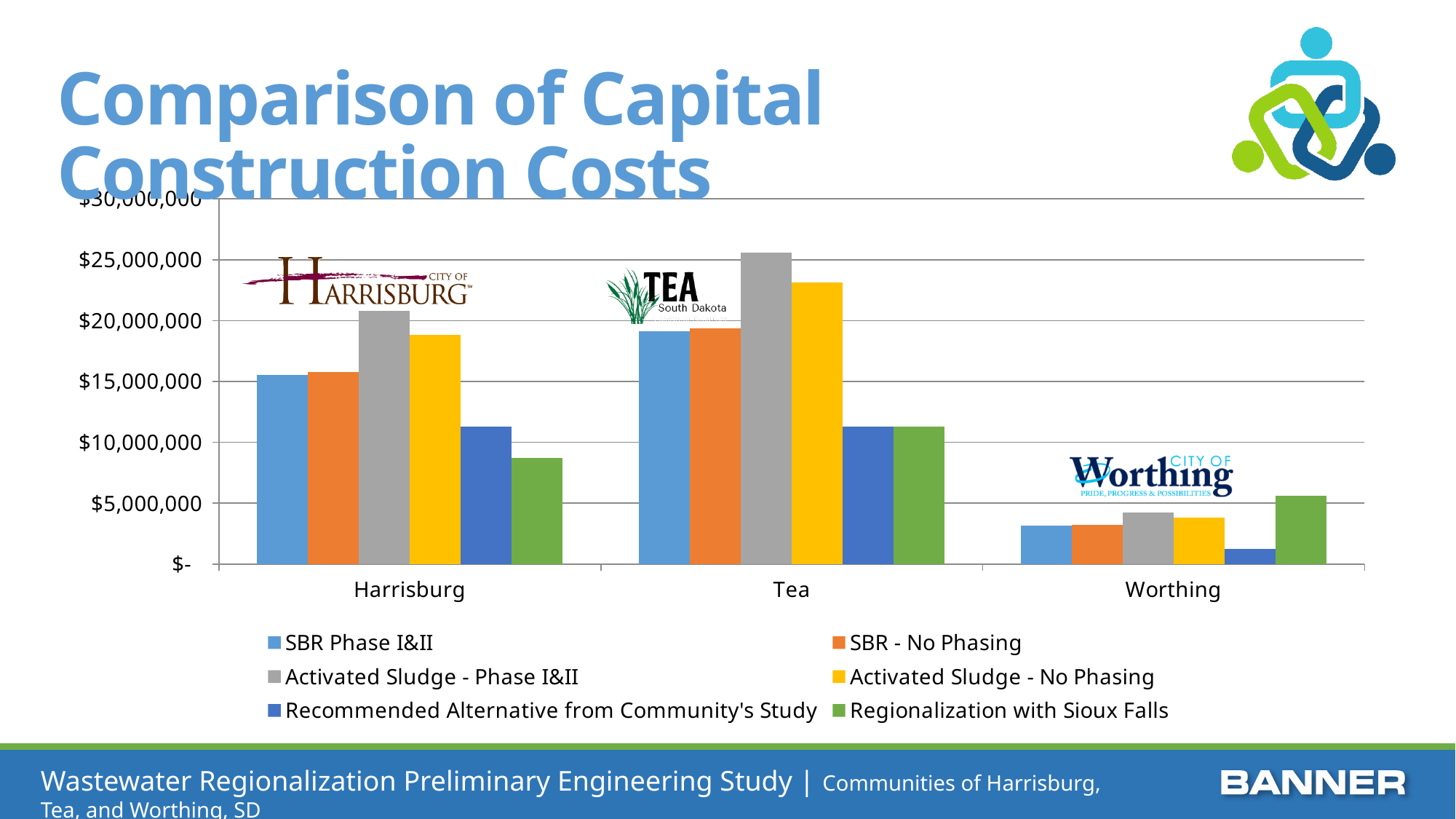
Is the value for Regionalization with Sioux Falls for Harrisburg greater or less than $10,000,000? less Is the value for Regionalization with Sioux Falls for Worthing greater or less than $5,000,000? greater For Harrisburg, which is larger: Recommended Alternative from Community's Study or Regionalization with Sioux Falls? Recommended Alternative from Community's Study Which community has the highest value for Activated Sludge - Phase I&II? Tea For Worthing, which series has the lowest value? Recommended Alternative from Community's Study How many communities are shown on the x axis of the chart? 3 Which is larger: Activated Sludge - No Phasing for Tea or Activated Sludge - Phase I&II for Harrisburg? Activated Sludge - No Phasing for Tea For Harrisburg, which series has the highest value? Activated Sludge - Phase I&II What is the title of the slide's chart? Comparison of Capital Construction Costs What kind of chart is shown on the slide? bar chart Is the value for Activated Sludge - Phase I&II for Harrisburg greater or less than $20,000,000? greater How many series does the chart's legend list? 6